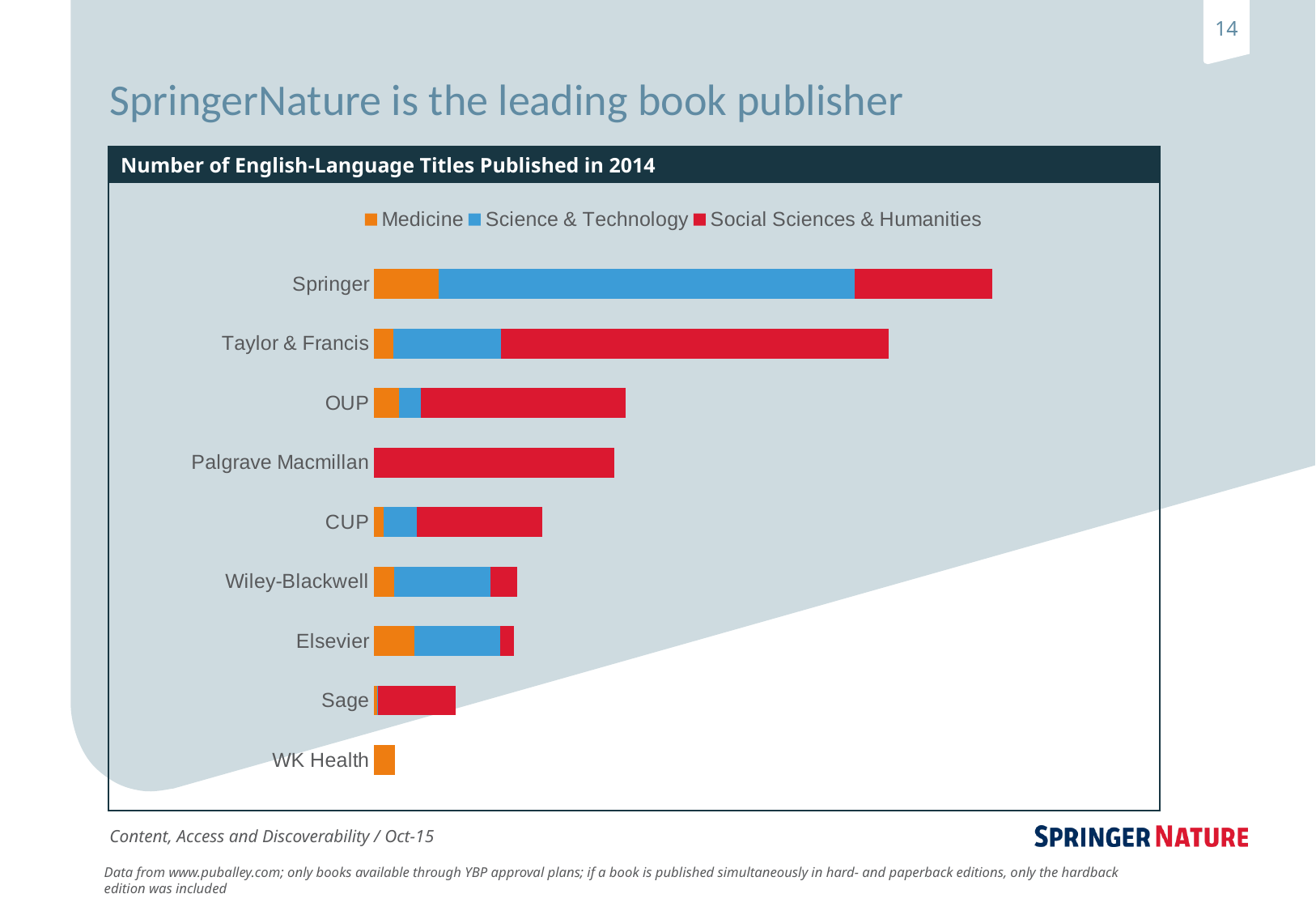
Which has the larger total bar, Palgrave Macmillan or Sage? Palgrave Macmillan Which publisher's bar consists only of the Medicine series? WK Health Which series makes up the largest part of Springer's bar? Science & Technology How many series does the legend list? 3 Which colour represents Medicine in the legend? Orange Which has the larger total bar, Springer or Taylor & Francis? Springer How many publishers are shown in the chart? 9 What is the title of the chart? Number of English-Language Titles Published in 2014 Which publisher has the longest total bar? Springer What kind of chart is shown on the slide? Stacked bar chart Which publisher has the shortest total bar? WK Health